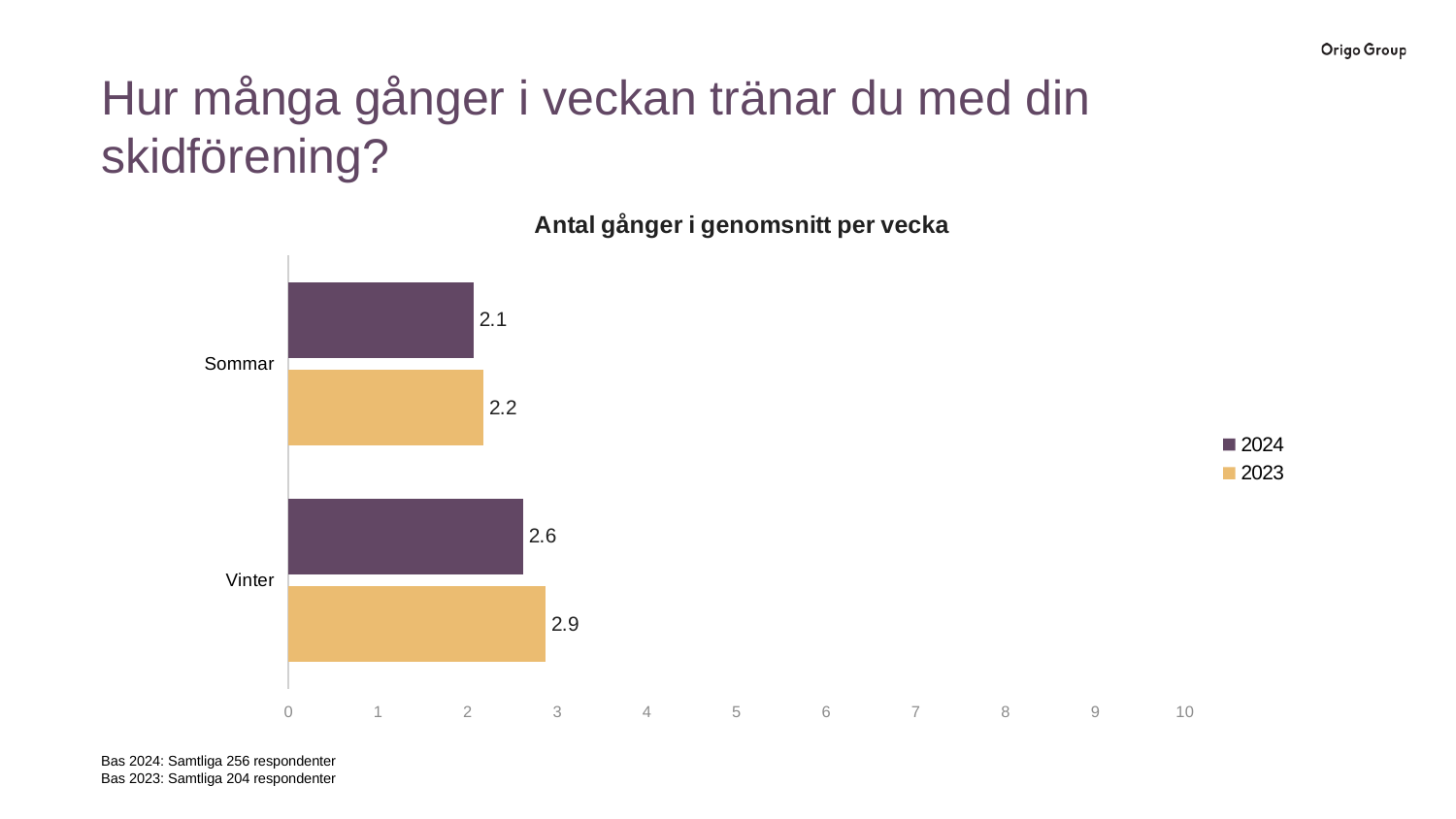
How many categories are shown on the chart? 2 Is the value for Vinter in 2023 greater or less than 3? less Which category has the highest value in the 2023 series? Vinter Which category has the lowest value in the 2024 series? Sommar What is the value for Sommar in the 2024 series? 2.1 What is the value for Vinter in the 2024 series? 2.6 Which is larger for Sommar: the 2024 value or the 2023 value? 2023 What kind of chart is shown on the slide? bar chart What is the value for Sommar in the 2023 series? 2.2 What is the value for Vinter in the 2023 series? 2.9 How many series does the legend list? 2 What is the difference between the 2023 and 2024 values for Vinter? 0.3